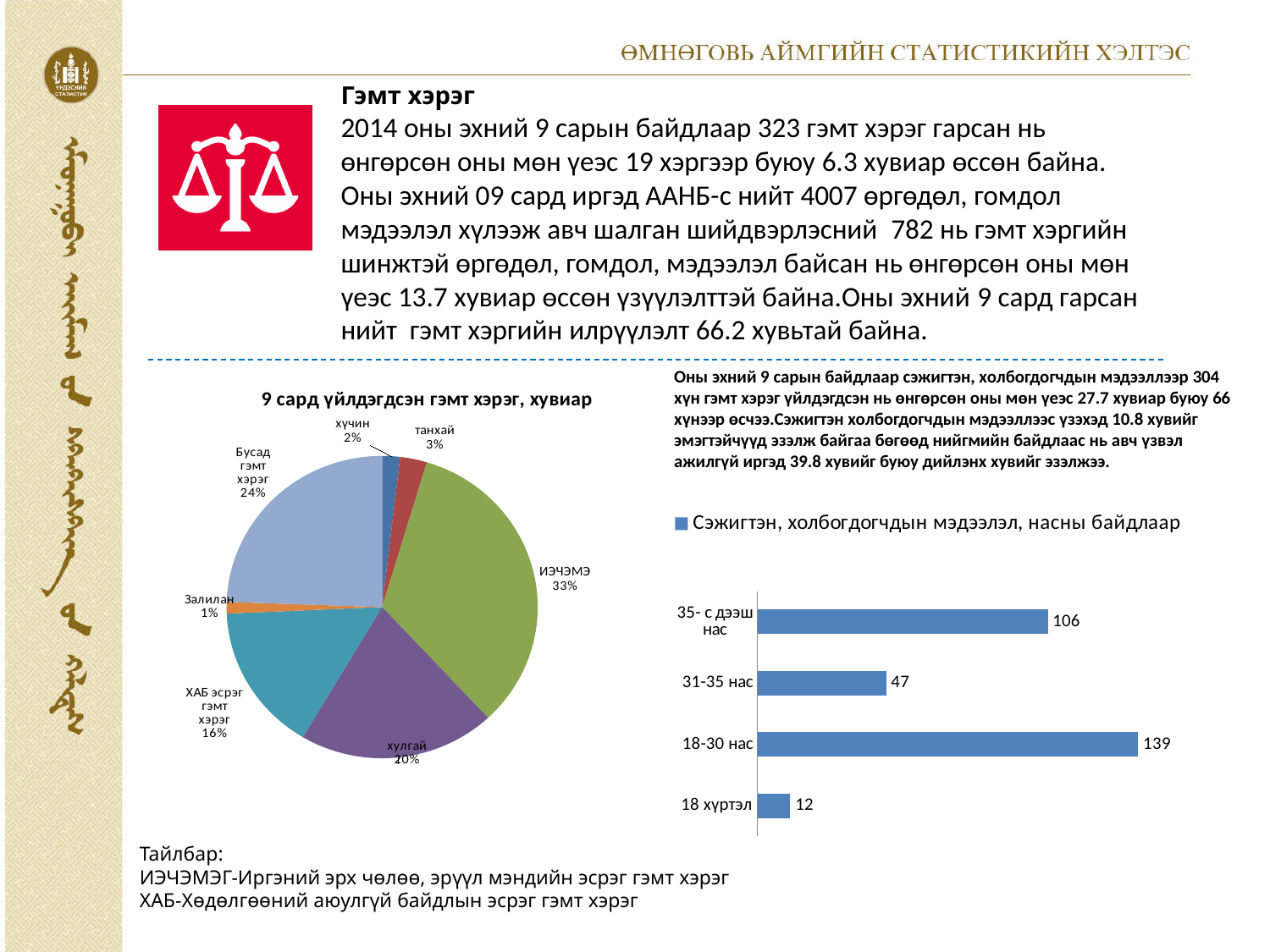
In the pie chart titled '9 сард үйлдэгдсэн гэмт хэрэг, хувиар', what share does ИЭЧЭМЭ have? 33% How many age categories are shown in the bar chart on the right? 4 In the bar chart on the right, which age group has the lowest value? 18 хүртэл In the pie chart titled '9 сард үйлдэгдсэн гэмт хэрэг, хувиар', what is the percentage for ХАБ эсрэг гэмт хэрэг? 16% In the bar chart on the right, which age group has the highest value? 18-30 нас In the bar chart on the right, what is the value for 35- с дээш нас? 106 In the bar chart on the right (Сэжигтэн, холбогдогчдын мэдээлэл, насны байдлаар), what is the value for 18-30 нас? 139 How many slices does the pie chart titled '9 сард үйлдэгдсэн гэмт хэрэг, хувиар' have? 7 In the bar chart on the right, which is larger: the value for 31-35 нас or the value for 18 хүртэл? 31-35 нас In the pie chart titled '9 сард үйлдэгдсэн гэмт хэрэг, хувиар', which category has the smallest slice? Залилан In the bar chart on the right, what is the difference between the values for 18-30 нас and 31-35 нас? 92 What type of chart is the chart on the right of the slide? bar chart